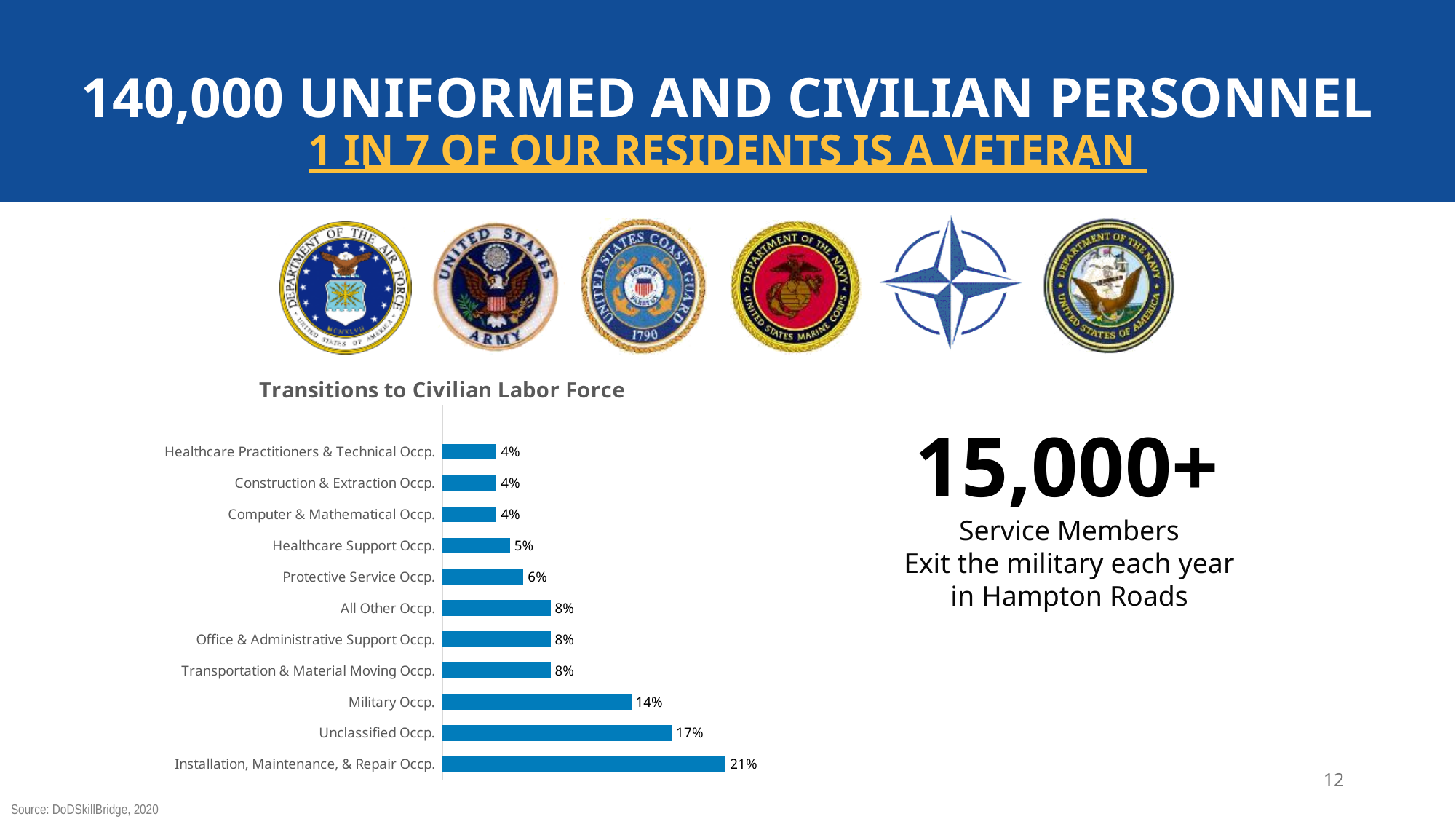
What is the value for Unclassified Occp.? 17% How many categories have a value of 8%? 3 What is the value for Installation, Maintenance, & Repair Occp.? 21% What is the difference between Military Occp. and Healthcare Support Occp.? 9% What is the title of the chart? Transitions to Civilian Labor Force Which category has the highest value? Installation, Maintenance, & Repair Occp. Which is larger, Military Occp. or Office & Administrative Support Occp.? Military Occp. What is the difference between Installation, Maintenance, & Repair Occp. and Unclassified Occp.? 4% What kind of chart is shown on the slide? Bar chart How many categories are shown in the chart? 11 What is the value for Military Occp.? 14% What is the value for Protective Service Occp.? 6%